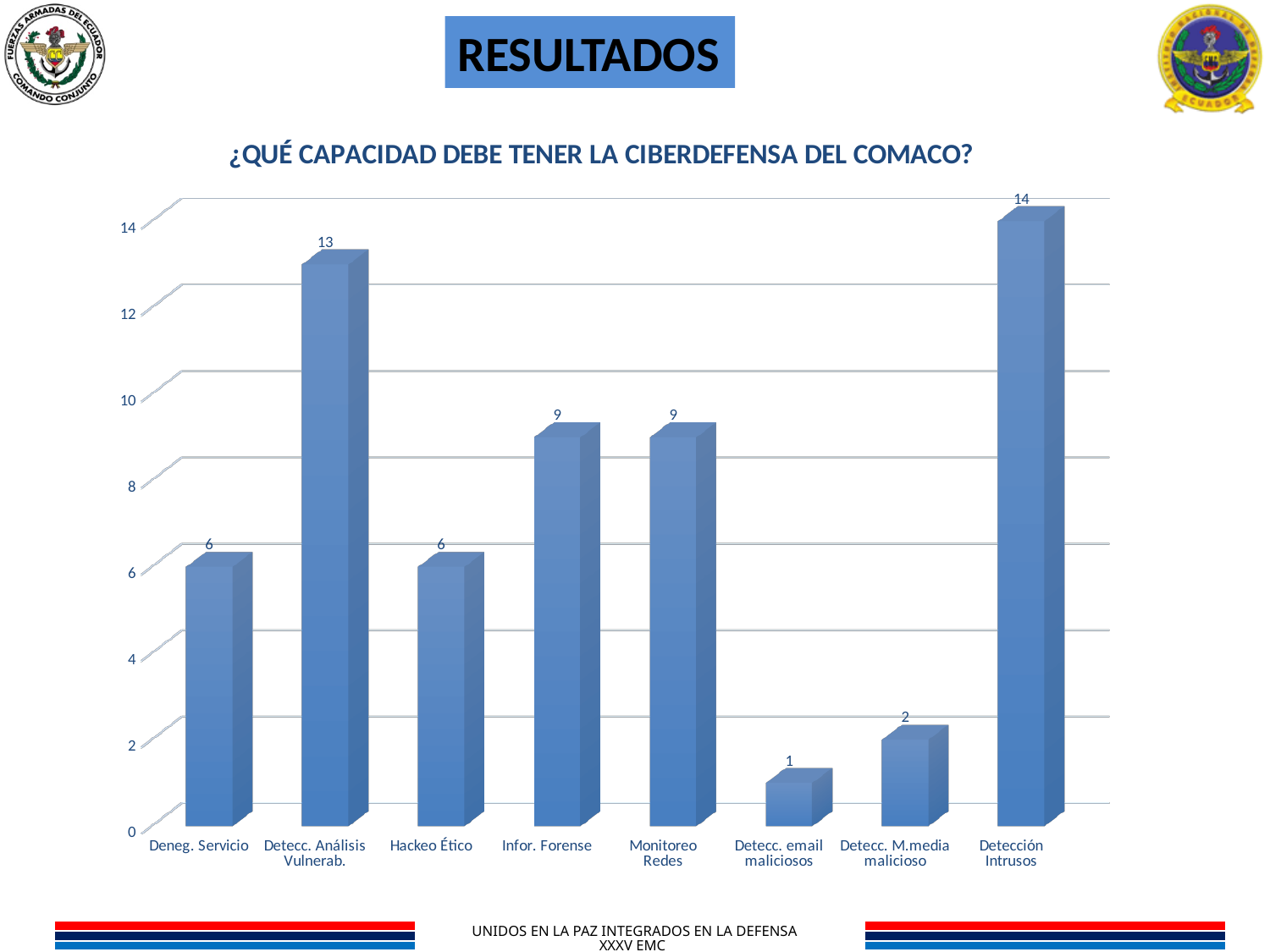
What is the title of the chart? ¿QUÉ CAPACIDAD DEBE TENER LA CIBERDEFENSA DEL COMACO? Which category has the lowest value? Detecc. email maliciosos How many categories are shown on the x axis? 8 What is the value for Infor. Forense? 9 Which category has the highest value? Detección Intrusos Which is larger, the value for Hackeo Ético or the value for Monitoreo Redes? Monitoreo Redes What is the difference between the values for Detección Intrusos and Detecc. M.media malicioso? 12 What is the value for Detecc. email maliciosos? 1 What kind of chart is shown on the slide? Bar chart What is the difference between the values for Detecc. Análisis Vulnerab. and Deneg. Servicio? 7 What is the value for Detección Intrusos? 14 What is the value for Detecc. Análisis Vulnerab.? 13